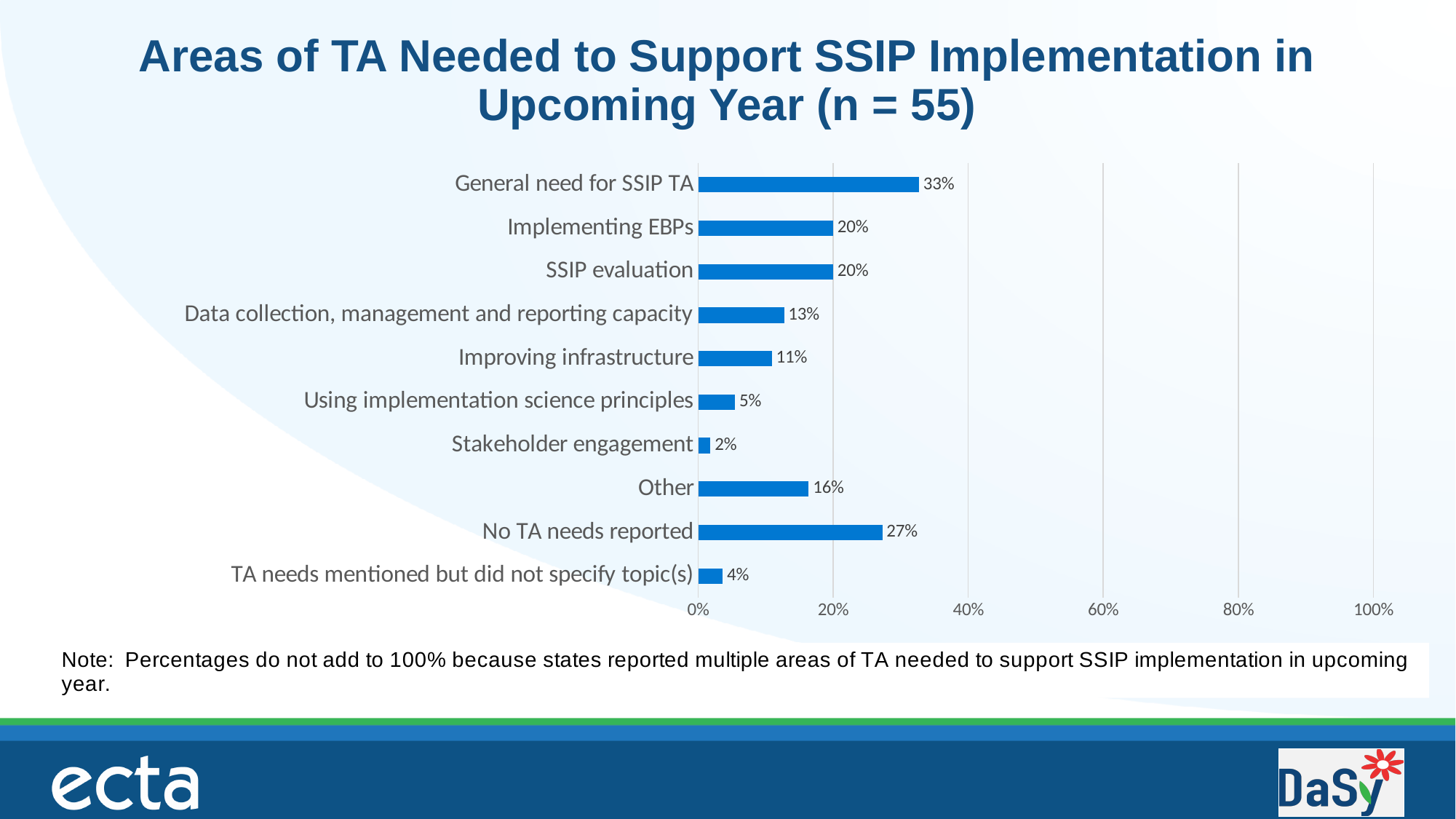
How many categories are shown in the chart? 10 What is the value for Stakeholder engagement? 2% What is the difference between General need for SSIP TA and No TA needs reported? 6% Which category has the lowest percentage? Stakeholder engagement Which category has the highest percentage? General need for SSIP TA What is the difference between Data collection, management and reporting capacity and Using implementation science principles? 8% What percentage is shown for No TA needs reported? 27% What kind of chart is shown on the slide? Bar chart Is the value for General need for SSIP TA greater or less than 40%? less What is the value for Improving infrastructure? 11% Which is larger, Other or Improving infrastructure? Other What percentage of states reported a general need for SSIP TA? 33%